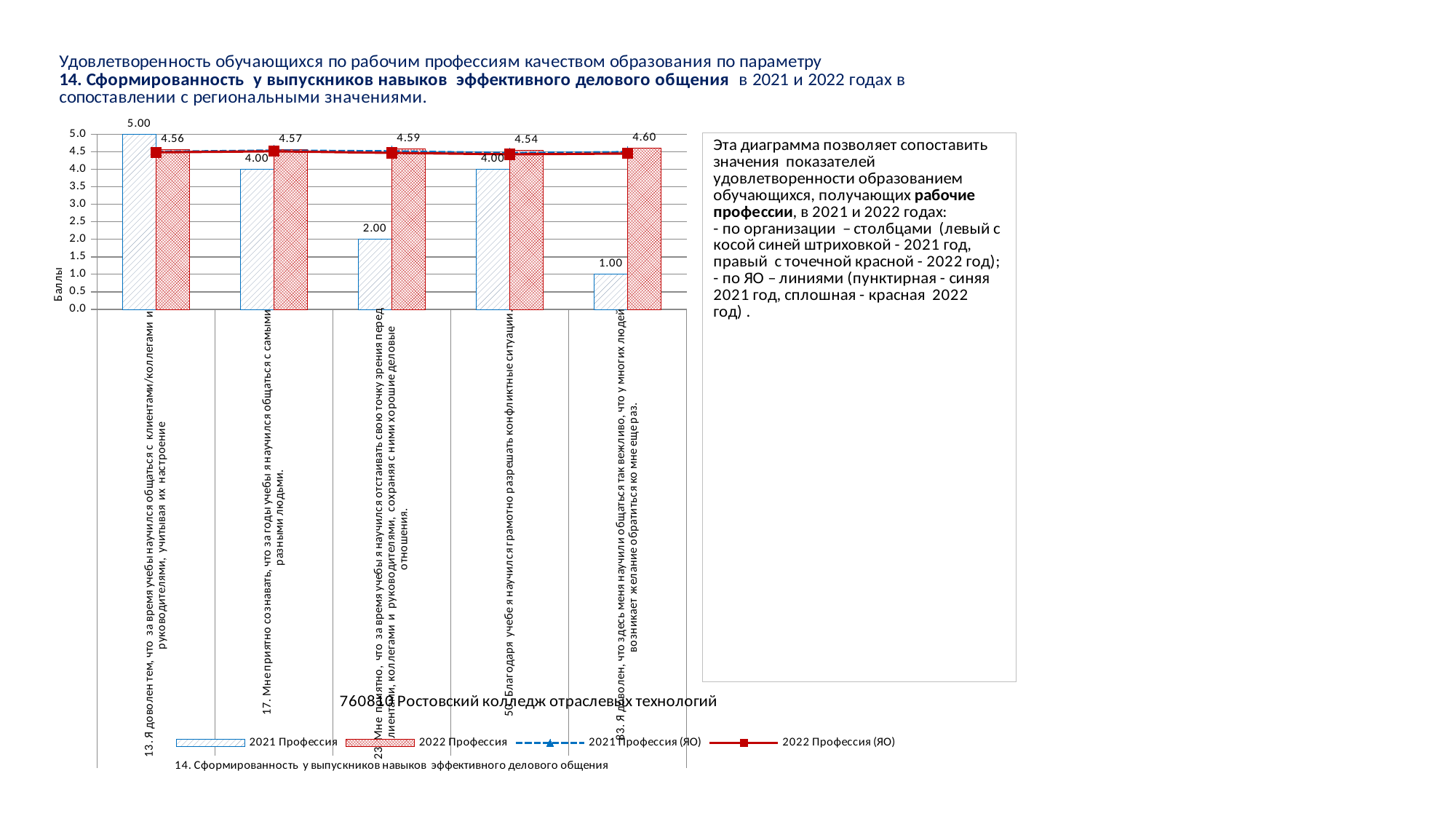
What is the 2022 Профессия value for statement 23 (Мне приятно, что за время учебы я научился отстаивать свою точку зрения)? 4.59 Which statement has the highest 2021 Профессия value? 13 What is the 2021 Профессия value for statement 13 (Я доволен тем, что за время учебы научился общаться с клиентами/коллегами и руководителями)? 5.00 How many series does the chart legend list? 4 What is the difference between the 2022 Профессия and 2021 Профессия values for statement 83? 3.60 Which statement has the lowest 2021 Профессия value? 83 What is the title of the vertical axis of the chart? Баллы Which has the larger 2021 Профессия value: statement 17 or statement 23? Statement 17 How many statements (categories) are shown on the x axis of the chart? 5 What is the difference between the 2021 Профессия values for statement 13 and statement 23? 3.00 What is the 2021 Профессия value for statement 83 (Я доволен, что здесь меня научили общаться так вежливо)? 1.00